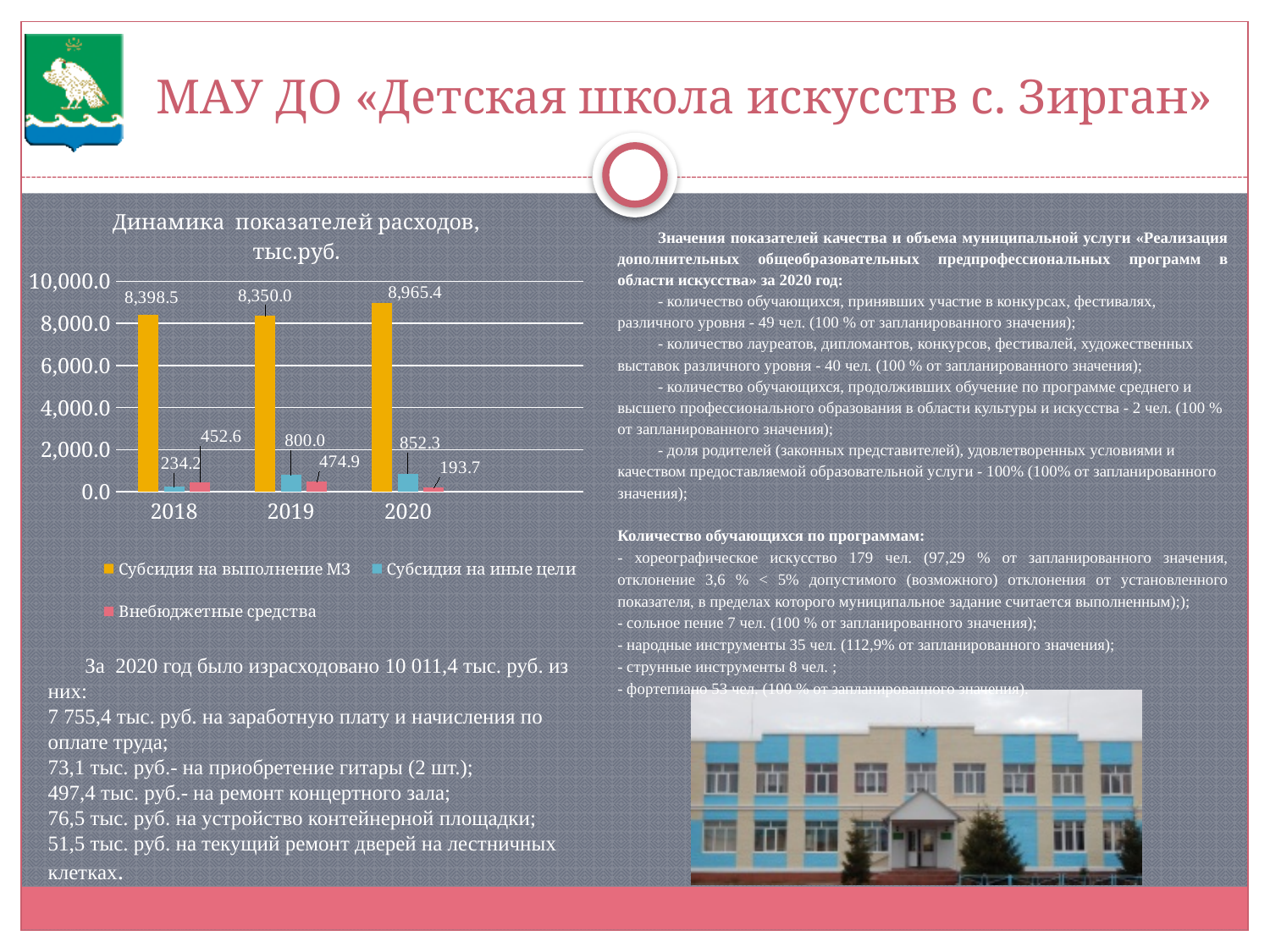
What is the value of Субсидия на выполнение МЗ for 2020? 8,965.4 Which is larger in 2020: Субсидия на иные цели or Внебюджетные средства? Субсидия на иные цели In which year is Субсидия на иные цели the lowest? 2018 Is the value of Субсидия на выполнение МЗ for 2018 greater or less than 8,000.0? greater What is the difference between Субсидия на выполнение МЗ in 2020 and in 2019? 615.4 In which year is Субсидия на выполнение МЗ the highest? 2020 How many series does the chart legend list? 3 What type of chart is shown on the slide? bar chart What is the title of the chart? Динамика показателей расходов, тыс.руб. What is the value of Субсидия на иные цели for 2019? 800.0 What is the value of Внебюджетные средства for 2018? 452.6 How many years are shown on the x axis of the chart? 3